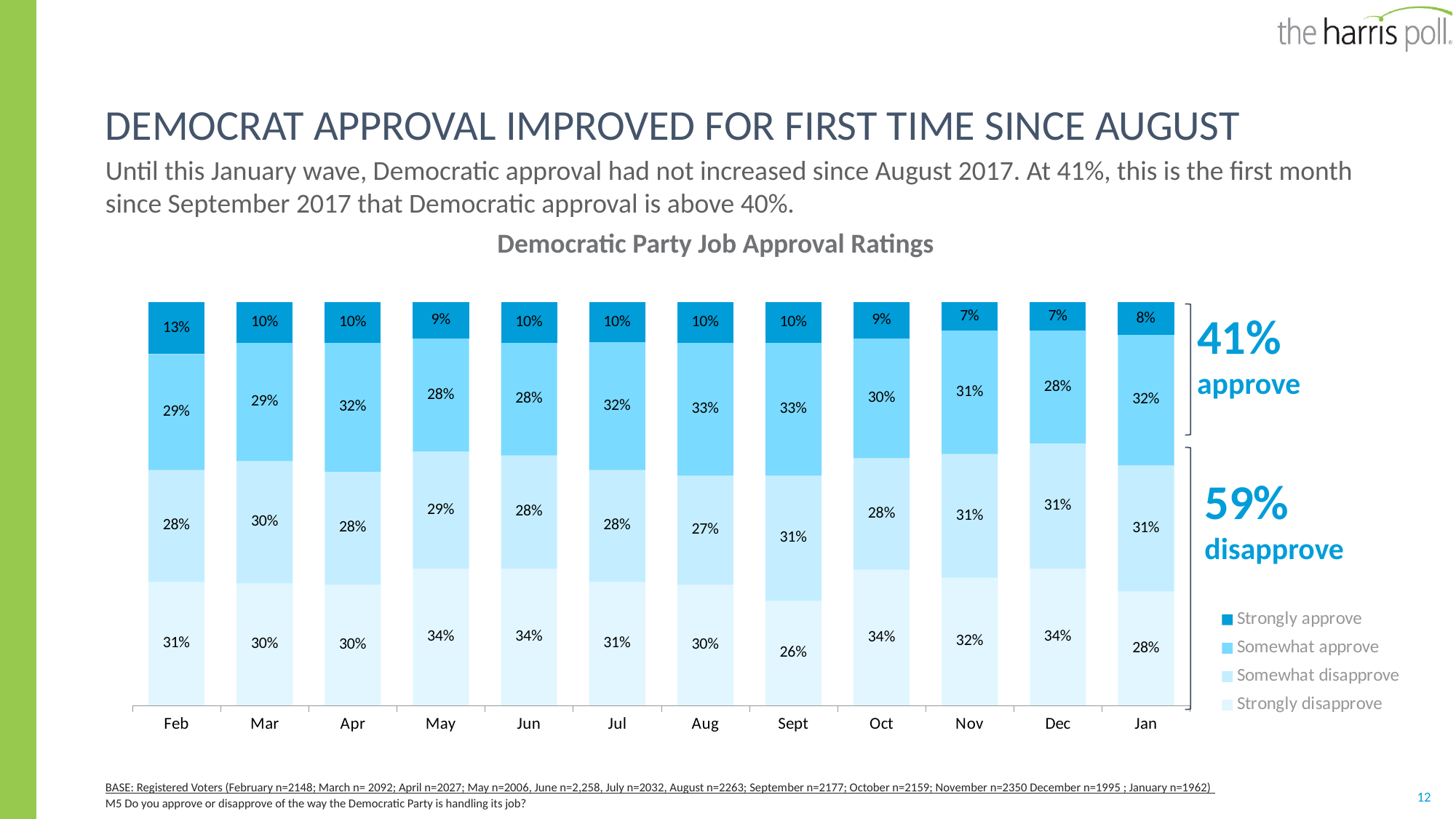
What kind of chart is shown on the slide? Stacked bar chart How many series does the legend list? 4 What is the Somewhat disapprove value for Aug? 27% How many months are shown on the x axis of the chart? 12 What is the Strongly disapprove value for Sept? 26% According to the annotation beside the chart, what percentage approve in the latest (Jan) wave? 41% What is the Strongly approve value for Feb? 13% Which month has the larger Strongly disapprove value, May or Jan? May In which month is the Strongly disapprove value lowest? Sept Does the Strongly approve value generally rise or fall from Feb to Dec? Fall In which month is the Strongly approve value highest? Feb What is the difference between the Somewhat approve values for Jan and Dec? 4 percentage points